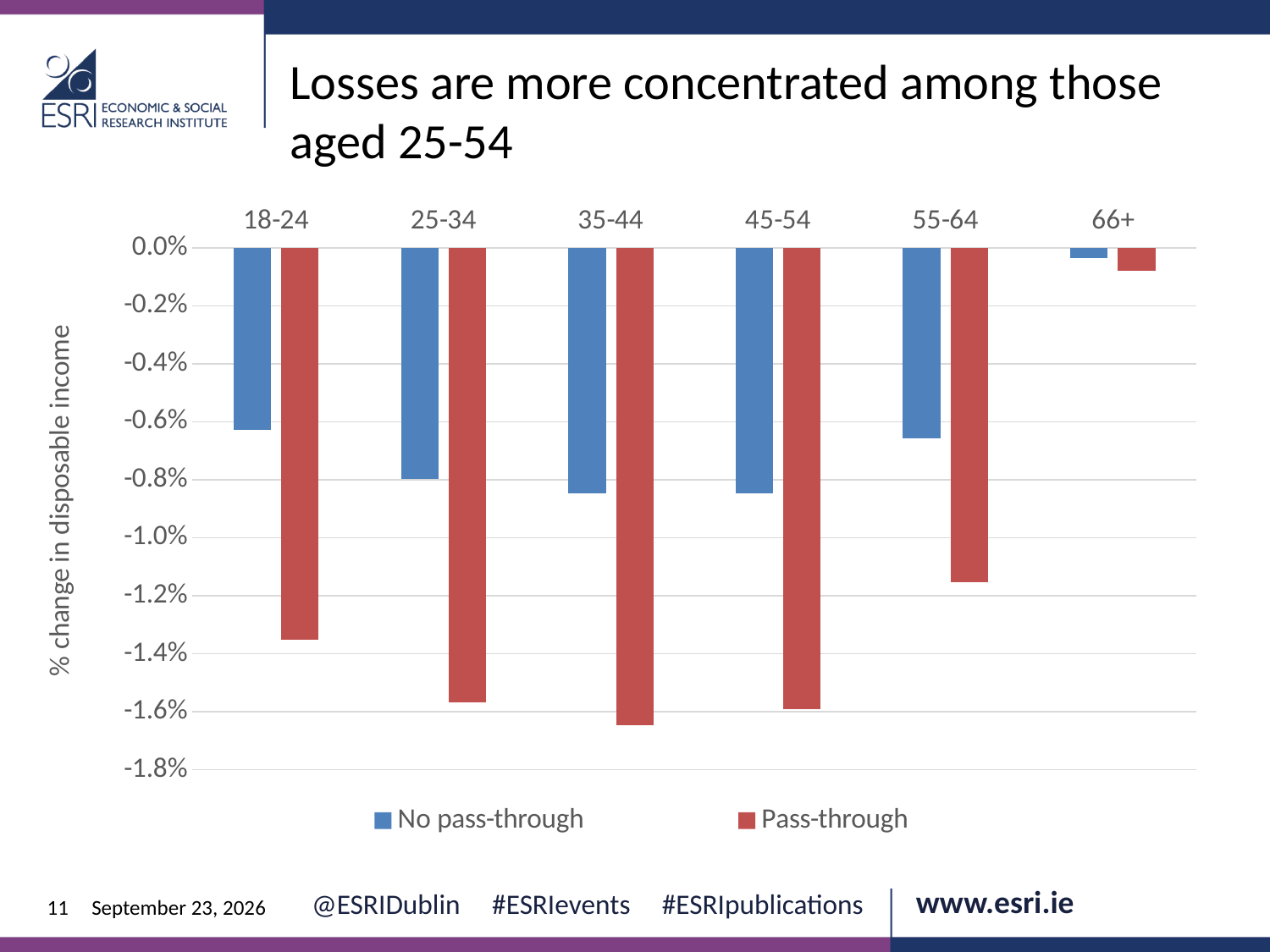
Which age group has the smallest loss in disposable income under the Pass-through scenario? 66+ What kind of chart is shown on the slide? Bar chart Is the Pass-through value for the 18-24 age group greater or less than -1.2%? less For the 18-24 age group, which scenario shows the larger loss in disposable income, No pass-through or Pass-through? Pass-through Is the No pass-through value for the 66+ age group greater or less than -0.2%? greater Do the Pass-through losses increase or decrease in size moving from the 45-54 group to the 66+ group? decrease Which age group has the largest loss in disposable income under the Pass-through scenario? 35-44 How many series does the chart's legend list? 2 Under the Pass-through scenario, which age group shows a larger loss, 18-24 or 55-64? 18-24 Which age group has the smallest loss in disposable income under the No pass-through scenario? 66+ How many age groups are shown on the x axis of the chart? 6 What is the label on the chart's vertical axis? % change in disposable income